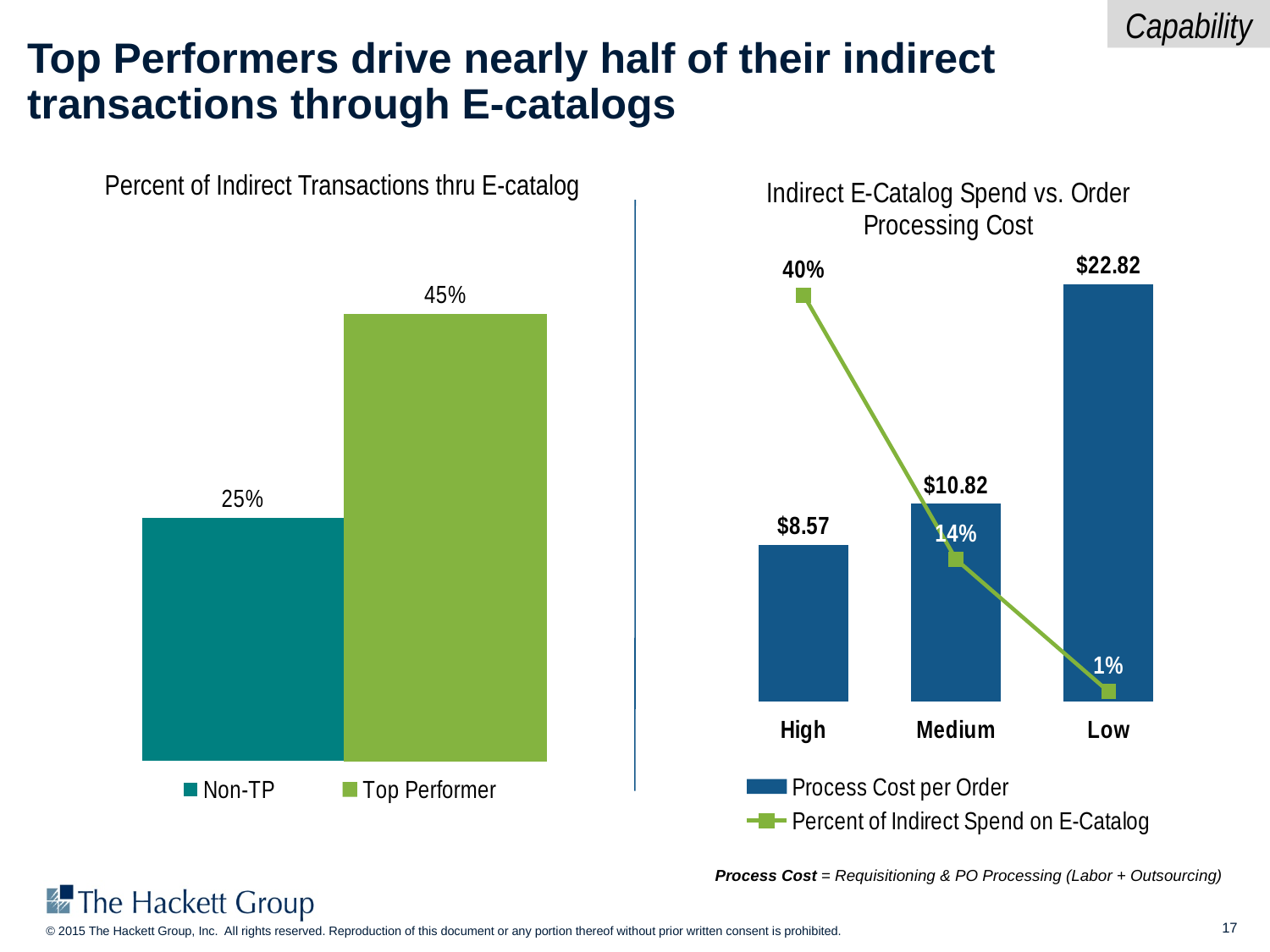
In the 'Percent of Indirect Transactions thru E-catalog' chart, what is the value for Non-TP? 25% In the 'Percent of Indirect Transactions thru E-catalog' chart, how many series does the legend list? 2 In the 'Indirect E-Catalog Spend vs. Order Processing Cost' chart, which series is drawn as a line? Percent of Indirect Spend on E-Catalog In the 'Indirect E-Catalog Spend vs. Order Processing Cost' chart, how many categories are shown on the x axis? 3 In the 'Indirect E-Catalog Spend vs. Order Processing Cost' chart, what is the Process Cost per Order for Medium? $10.82 In the 'Indirect E-Catalog Spend vs. Order Processing Cost' chart, which category has the highest Process Cost per Order? Low In the 'Indirect E-Catalog Spend vs. Order Processing Cost' chart, what is the difference in Process Cost per Order between Low and High? $14.25 In the 'Indirect E-Catalog Spend vs. Order Processing Cost' chart, what is the Percent of Indirect Spend on E-Catalog for High? 40% In the 'Percent of Indirect Transactions thru E-catalog' chart, what is the value for Top Performer? 45% In the 'Indirect E-Catalog Spend vs. Order Processing Cost' chart, does the Percent of Indirect Spend on E-Catalog rise or fall from High to Low? fall In the 'Percent of Indirect Transactions thru E-catalog' chart, what is the difference between the Top Performer and Non-TP values? 20% In the 'Indirect E-Catalog Spend vs. Order Processing Cost' chart, which category has the lowest Percent of Indirect Spend on E-Catalog? Low